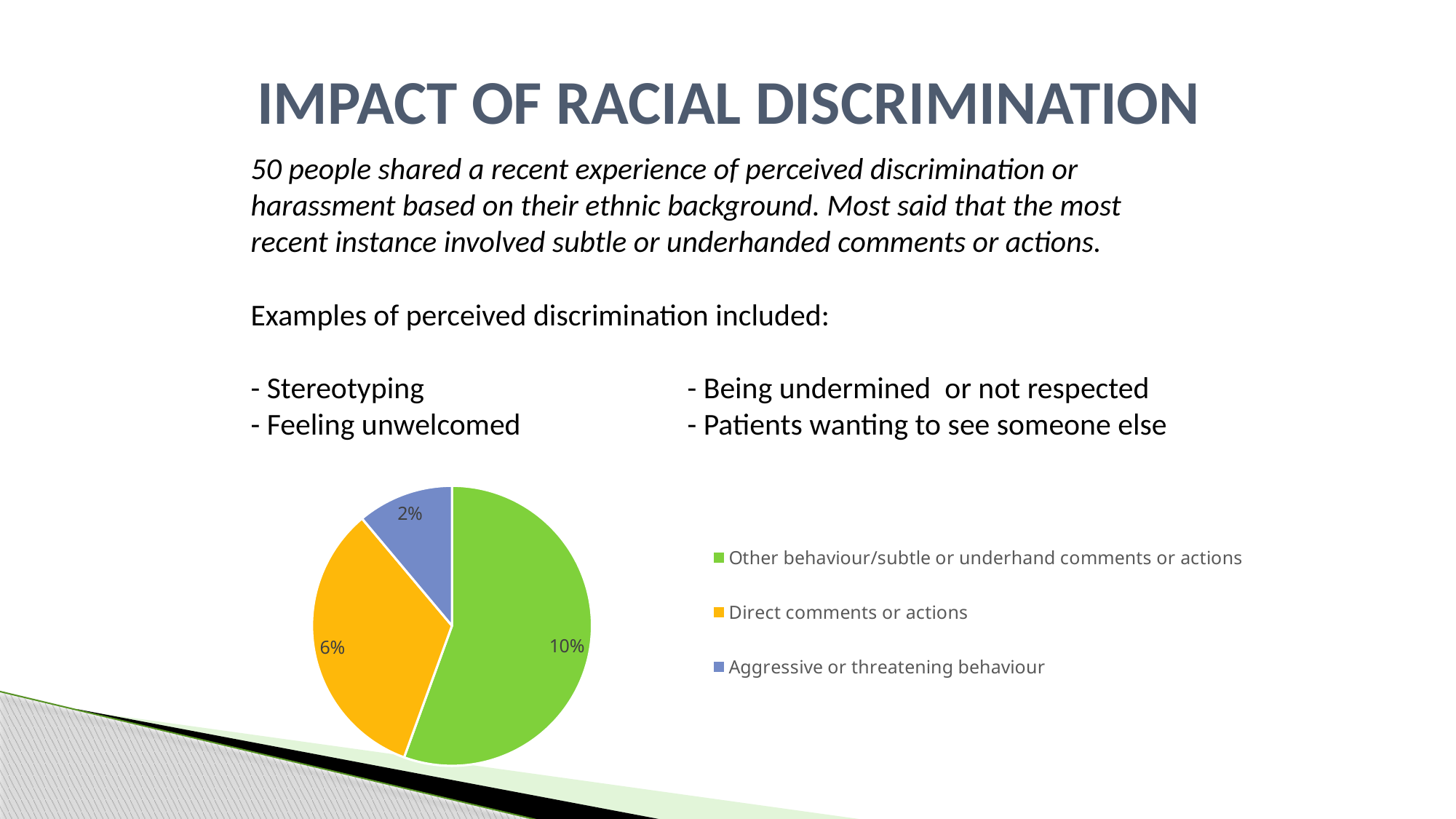
Which category has the smallest slice in the pie chart? Aggressive or threatening behaviour What is the difference between the labelled values for 'Direct comments or actions' and 'Aggressive or threatening behaviour'? 4% How many slices does the pie chart have? 3 What kind of chart is shown on the slide? Pie chart What value is shown for the 'Aggressive or threatening behaviour' slice of the pie chart? 2% How many entries does the chart legend list? 3 What value is shown for the 'Other behaviour/subtle or underhand comments or actions' slice of the pie chart? 10% What value is shown for the 'Direct comments or actions' slice of the pie chart? 6% What colour represents 'Direct comments or actions' in the pie chart? Orange What is the difference between the labelled values for 'Other behaviour/subtle or underhand comments or actions' and 'Direct comments or actions'? 4% Which category has the largest slice in the pie chart? Other behaviour/subtle or underhand comments or actions Which is larger in the pie chart: 'Direct comments or actions' or 'Aggressive or threatening behaviour'? Direct comments or actions